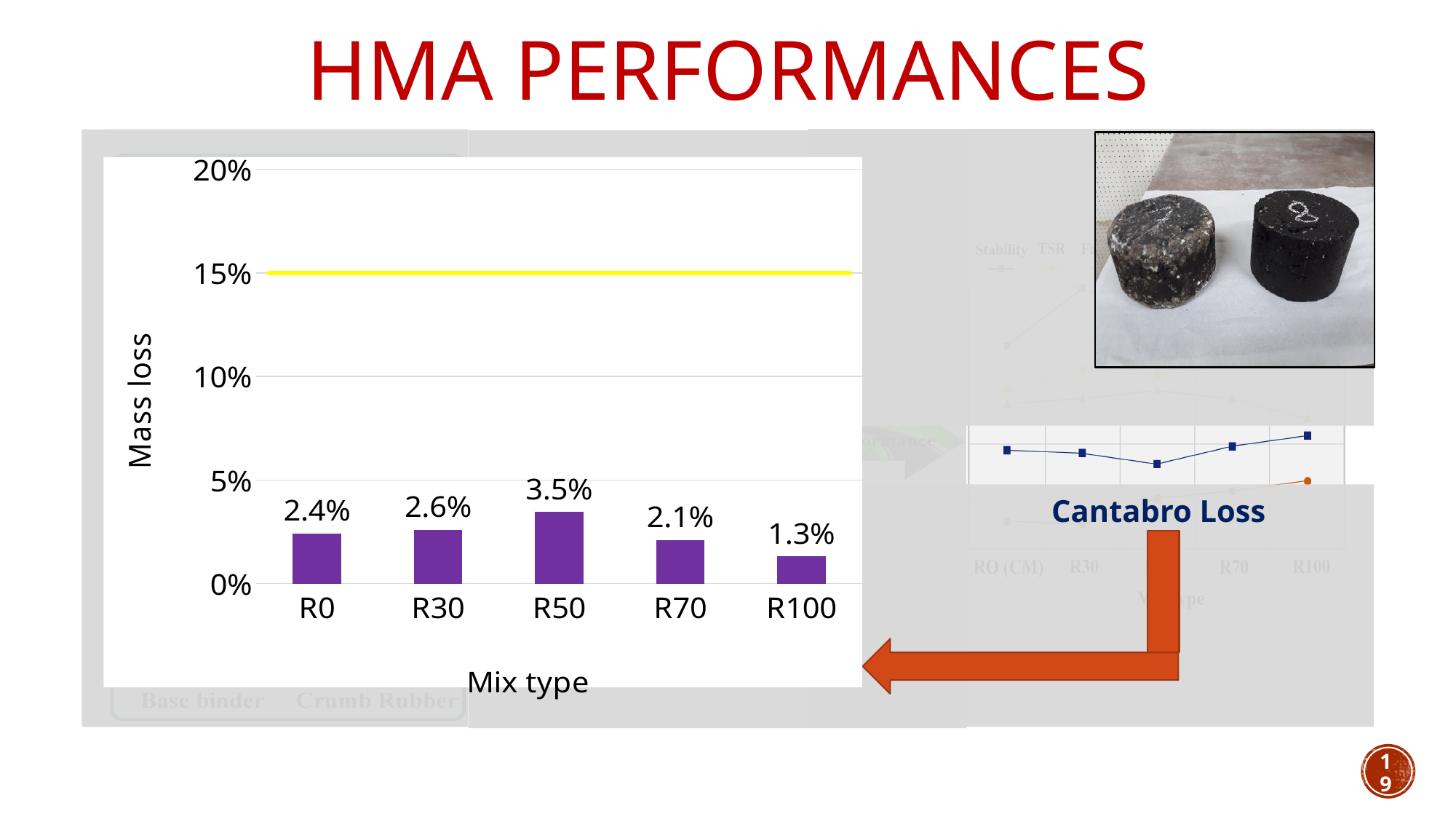
Which mix type has the lowest mass loss? R100 Is the mass loss for R50 greater or less than 5%? less How many mix types are shown on the x axis of the mass loss chart? 5 What is the mass loss for mix type R0? 2.4% What is the difference in mass loss between R50 and R100? 2.2% Does the mass loss rise or fall from R50 to R100? fall What is the mass loss for mix type R50? 3.5% What kind of chart is used to show mass loss by mix type? bar chart At what mass loss value is the yellow horizontal line drawn on the chart? 15% Which has a larger mass loss, R30 or R70? R30 What is the mass loss for mix type R100? 1.3% Which mix type has the highest mass loss? R50